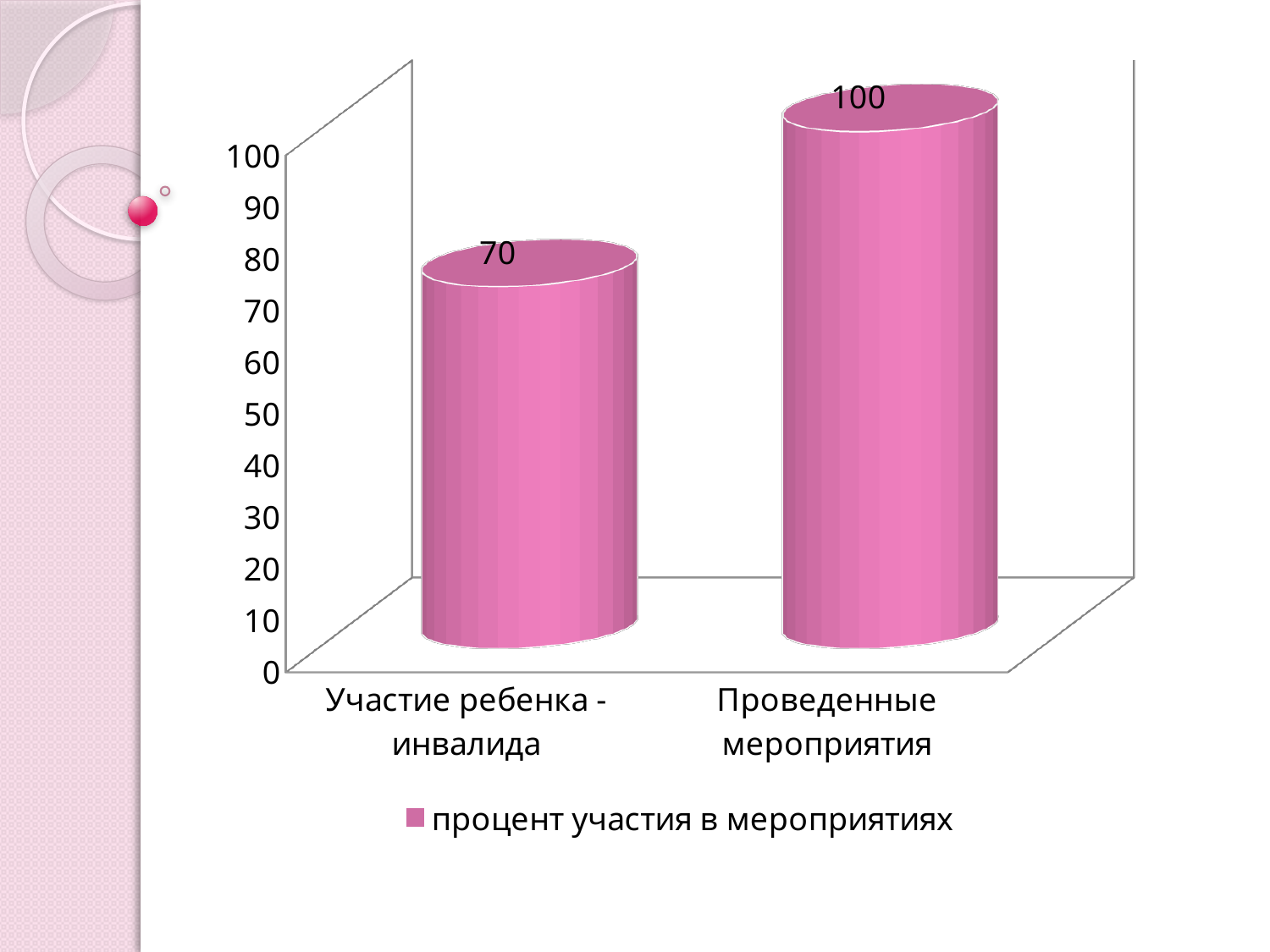
What is the highest tick value shown on the vertical axis? 100 What is the value for "Проведенные мероприятия"? 100 What kind of chart is shown on the slide? bar chart Is the value for "Участие ребенка - инвалида" greater or less than 50? greater Which is larger: the value for "Участие ребенка - инвалида" or the value for "Проведенные мероприятия"? Проведенные мероприятия How many series does the legend list? 1 How many categories are shown on the x axis? 2 Which category has the lowest value? Участие ребенка - инвалида What is the name of the series shown in the legend? процент участия в мероприятиях What is the value for "Участие ребенка - инвалида"? 70 What is the difference between the values for "Проведенные мероприятия" and "Участие ребенка - инвалида"? 30 Which category has the highest value? Проведенные мероприятия